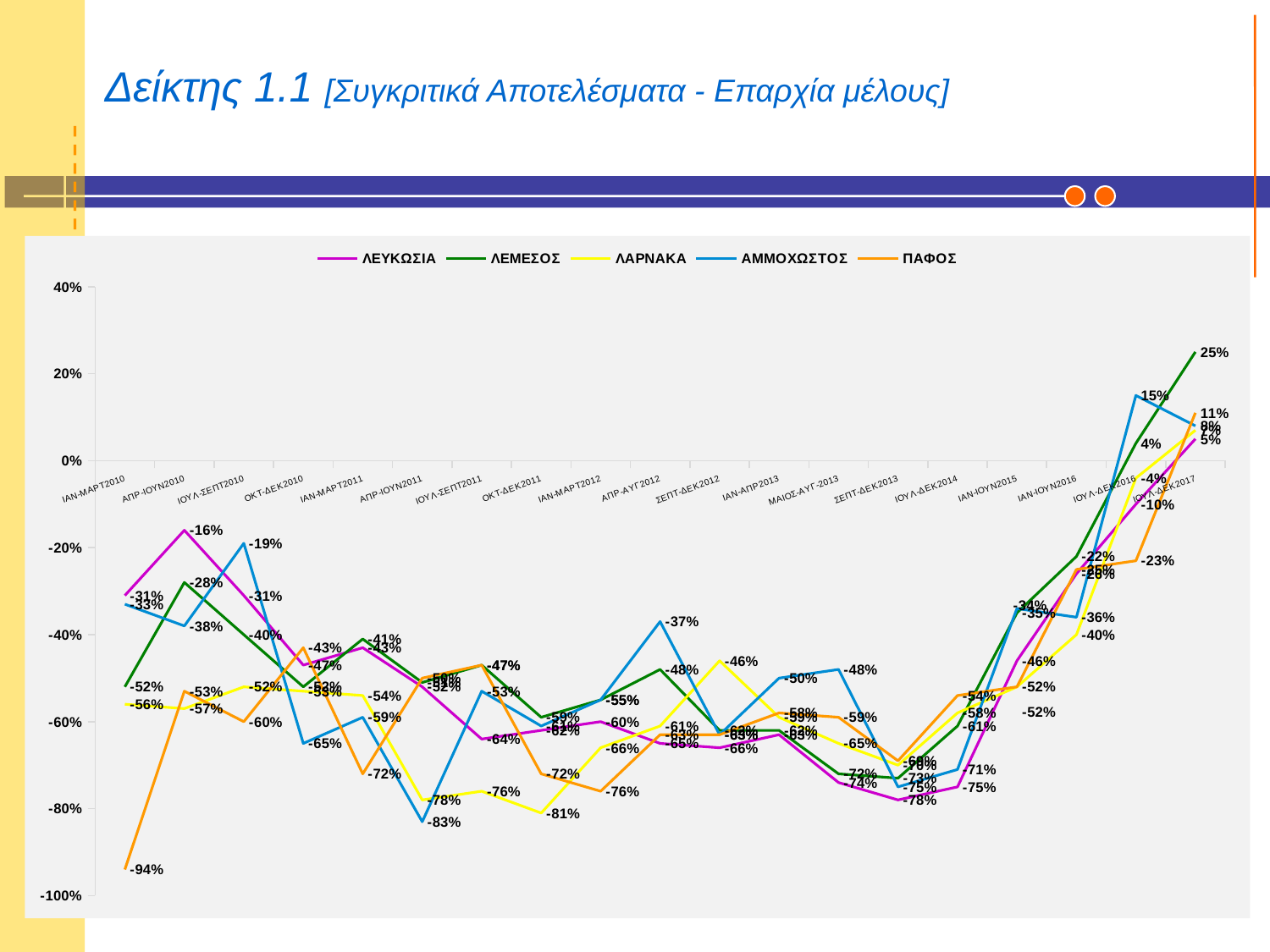
What is the value for ΑΜΜΟΧΩΣΤΟΣ at ΙΟΥΛ-ΔΕΚ2016? 15% What is the value for ΛΕΜΕΣΟΣ at ΙΟΥΛ-ΔΕΚ2017? 25% Which series reaches the highest value anywhere on the chart? ΛΕΜΕΣΟΣ Does the ΛΕΜΕΣΟΣ line rise or fall from ΙΟΥΛ-ΔΕΚ2014 to ΙΟΥΛ-ΔΕΚ2017? Rises How many series does the legend list? 5 At ΙΑΝ-ΜΑΡΤ2010, what is the difference between the ΛΕΥΚΩΣΙΑ value (-31%) and the ΠΑΦΟΣ value (-94%)? 63 percentage points What is the value for ΠΑΦΟΣ at ΙΑΝ-ΜΑΡΤ2010? -94% What is the value for ΑΜΜΟΧΩΣΤΟΣ at ΙΟΥΛ-ΣΕΠΤ2011? -53% What kind of chart is shown on the slide? Line chart Which series has the lowest value anywhere on the chart? ΠΑΦΟΣ At ΙΟΥΛ-ΣΕΠΤ2010, which is higher: ΛΕΥΚΩΣΙΑ or ΑΜΜΟΧΩΣΤΟΣ? ΑΜΜΟΧΩΣΤΟΣ Is the value for ΛΕΜΕΣΟΣ at ΙΟΥΛ-ΔΕΚ2017 greater or less than 20%? greater